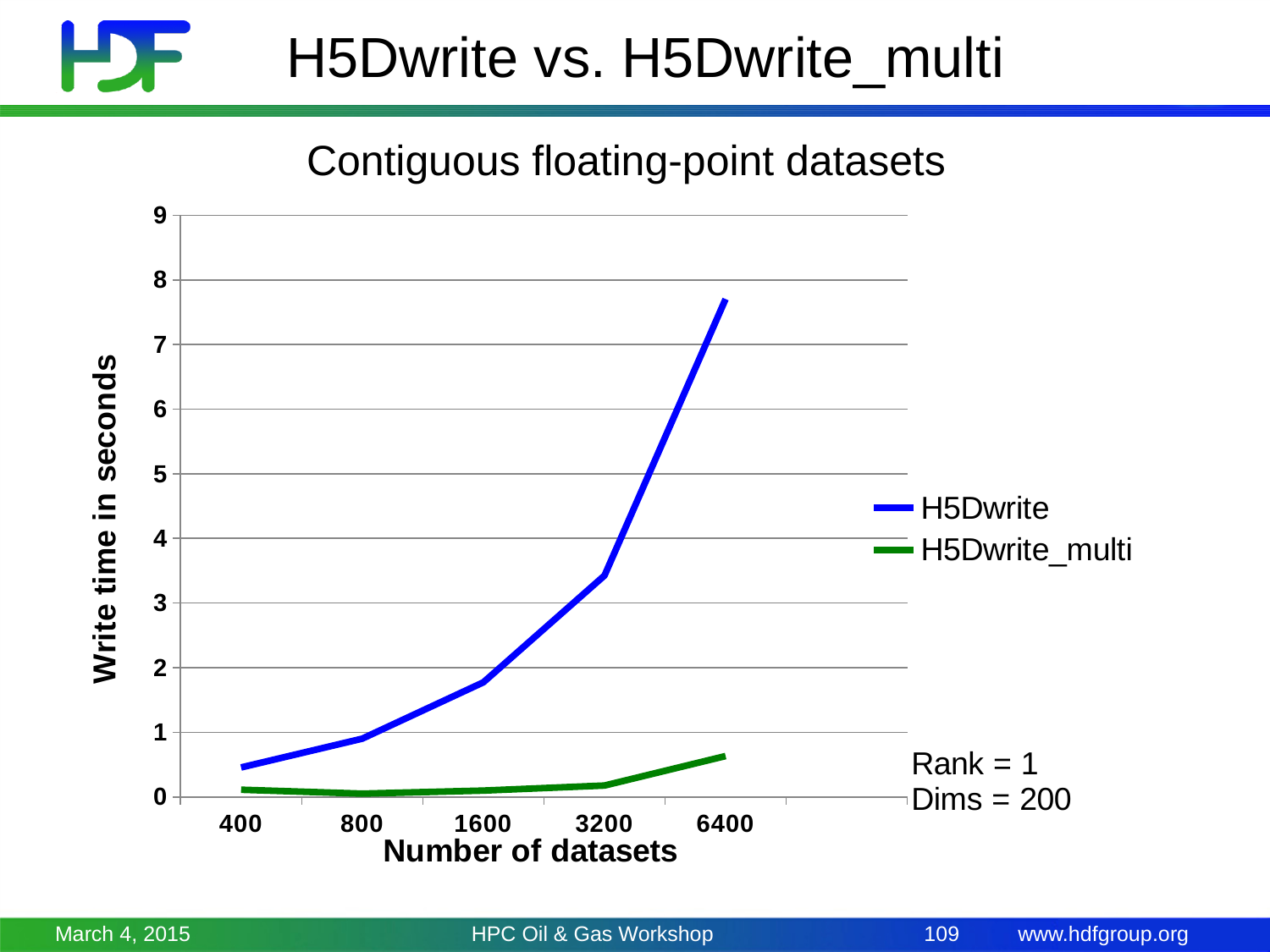
Is the H5Dwrite_multi value at 6400 datasets greater or less than 1? less What is the title of the chart? Contiguous floating-point datasets How many series does the legend list? 2 At which number of datasets does H5Dwrite reach its highest write time? 6400 How many points are plotted along the x axis for each series? 5 What kind of chart is shown on the slide? line chart Is the H5Dwrite value at 6400 datasets greater or less than 7? greater Is the H5Dwrite value at 3200 datasets greater or less than 3? greater Does the H5Dwrite write time rise or fall as the number of datasets increases? rise Which series has the higher write time at 6400 datasets? H5Dwrite What is the label of the y axis? Write time in seconds